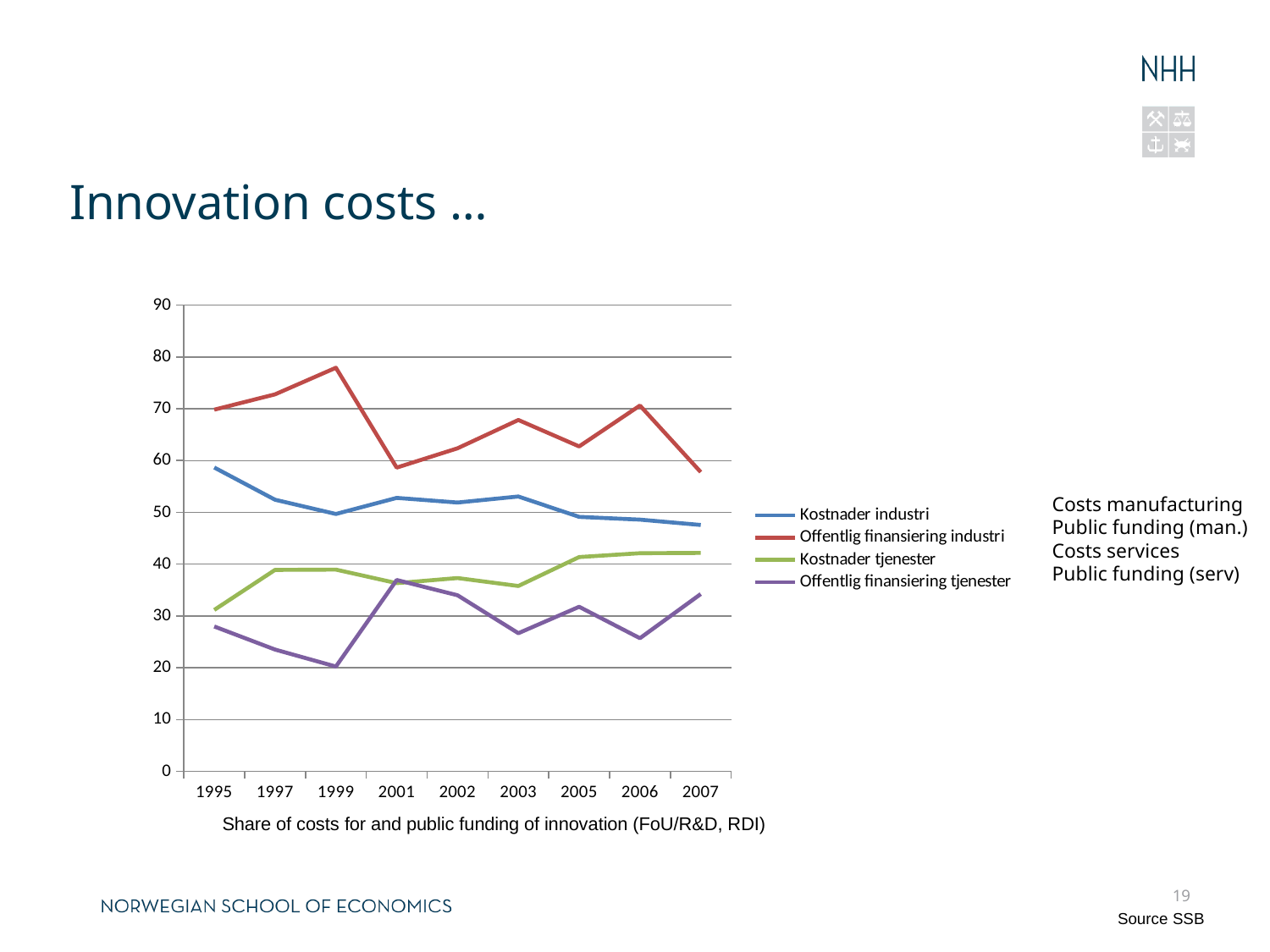
In which year is Offentlig finansiering tjenester at its lowest? 1999 How many years are shown on the x axis? 9 What kind of chart is shown on the slide? Line chart Is the value for Offentlig finansiering industri in 1999 greater or less than 70? greater Does Kostnader industri rise or fall overall from 1995 to 2007? Fall Is the value for Offentlig finansiering tjenester in 1999 greater or less than 30? less Which series is drawn with the red line? Offentlig finansiering industri In which year is Offentlig finansiering industri at its highest? 1999 In 1995, which is larger: Kostnader industri or Kostnader tjenester? Kostnader industri How many series does the legend list? 4 Which series has the highest value in 2007? Offentlig finansiering industri Is the value for Kostnader industri in 2007 greater or less than 50? less